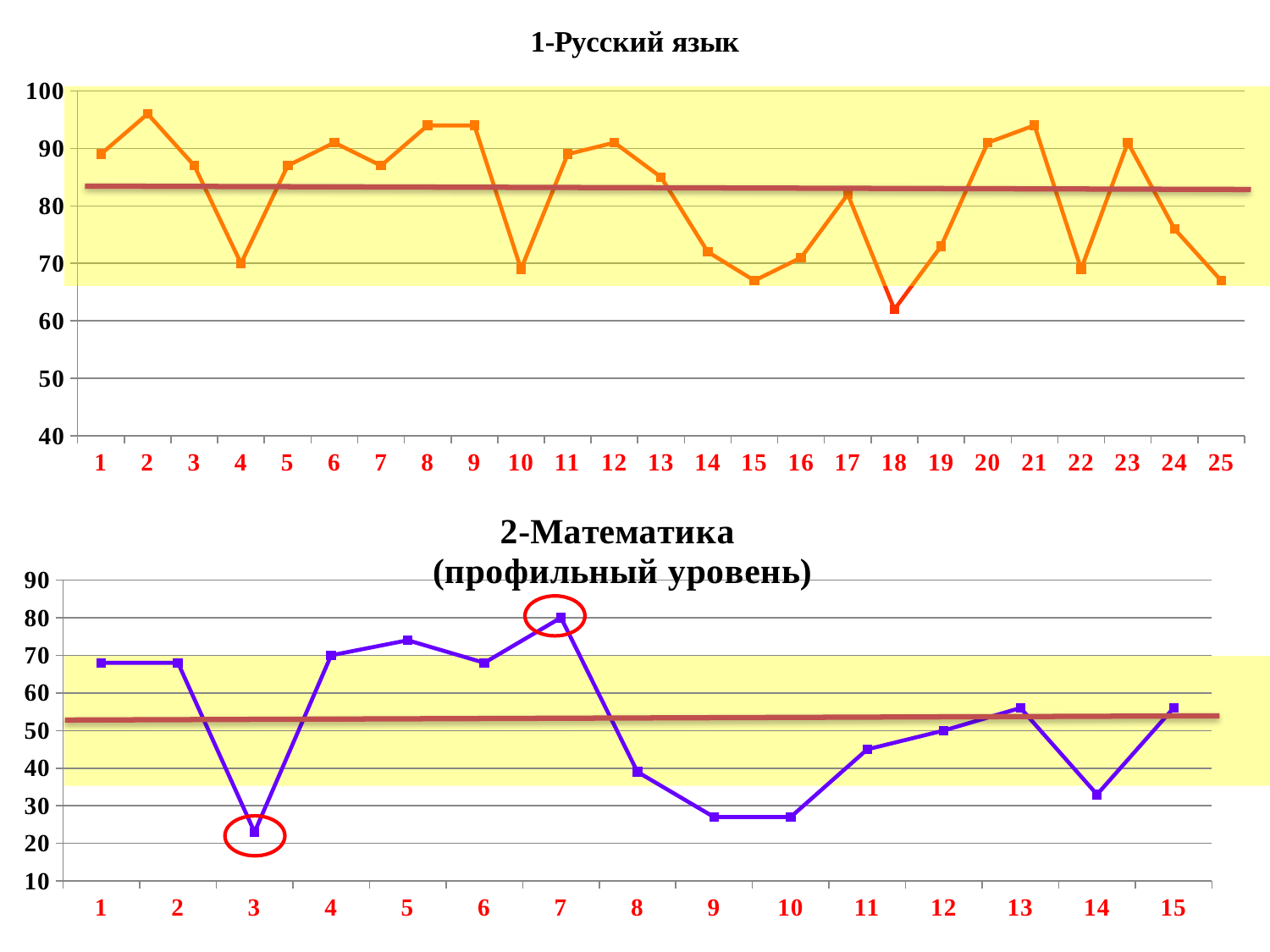
On the bottom chart "2-Математика (профильный уровень)", which point has the lowest value? 3 On the bottom chart "2-Математика (профильный уровень)", is the value for point 7 greater or less than 70? greater On the top chart "1-Русский язык", is the value for point 8 greater or less than 90? greater What is the title of the top chart on the slide? 1-Русский язык On the bottom chart "2-Математика (профильный уровень)", which is larger, the value for point 1 or the value for point 9? point 1 On the bottom chart "2-Математика (профильный уровень)", is the value for point 11 greater or less than 50? less How many data points are plotted on the top chart "1-Русский язык"? 25 On the bottom chart "2-Математика (профильный уровень)", which point has the highest value? 7 How many data points are plotted on the bottom chart "2-Математика (профильный уровень)"? 15 On the top chart "1-Русский язык", which point has the lowest value? 18 What kind of chart is the top chart titled "1-Русский язык"? line chart